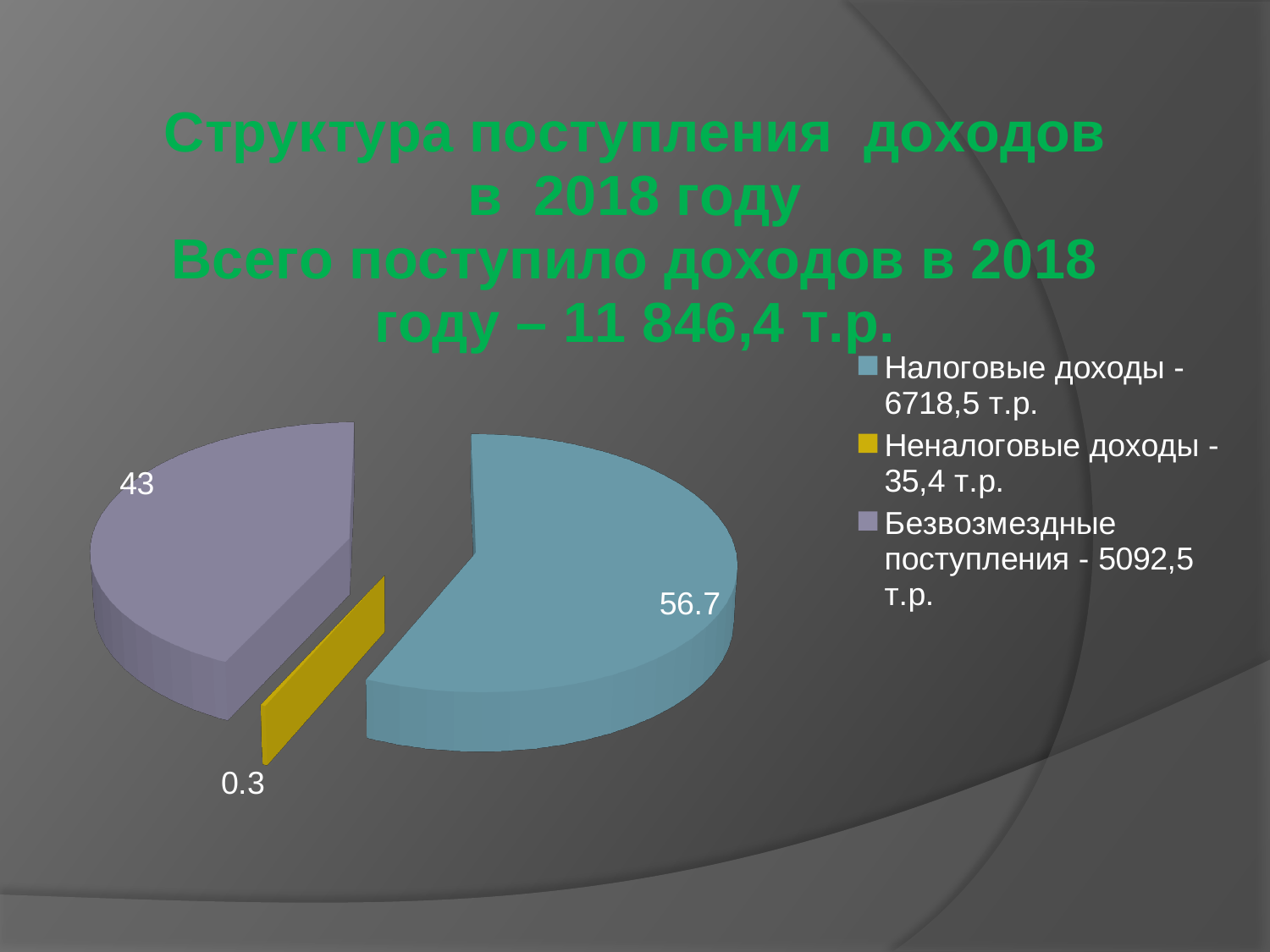
What value is labelled on the slice for Безвозмездные поступления? 43 Which slice is larger: Налоговые доходы or Безвозмездные поступления? Налоговые доходы What kind of chart is shown on the slide? pie chart What is the difference between the labelled values for Налоговые доходы and Безвозмездные поступления? 13.7 What colour is the slice for Неналоговые доходы? yellow What value is labelled on the slice for Налоговые доходы? 56.7 How many entries does the legend list? 3 Which category has the smallest slice of the pie? Неналоговые доходы Which category has the largest slice of the pie? Налоговые доходы According to the legend, what amount in т.р. corresponds to Безвозмездные поступления? 5092,5 т.р. What value is labelled on the slice for Неналоговые доходы? 0.3 How many slices does the pie chart have? 3